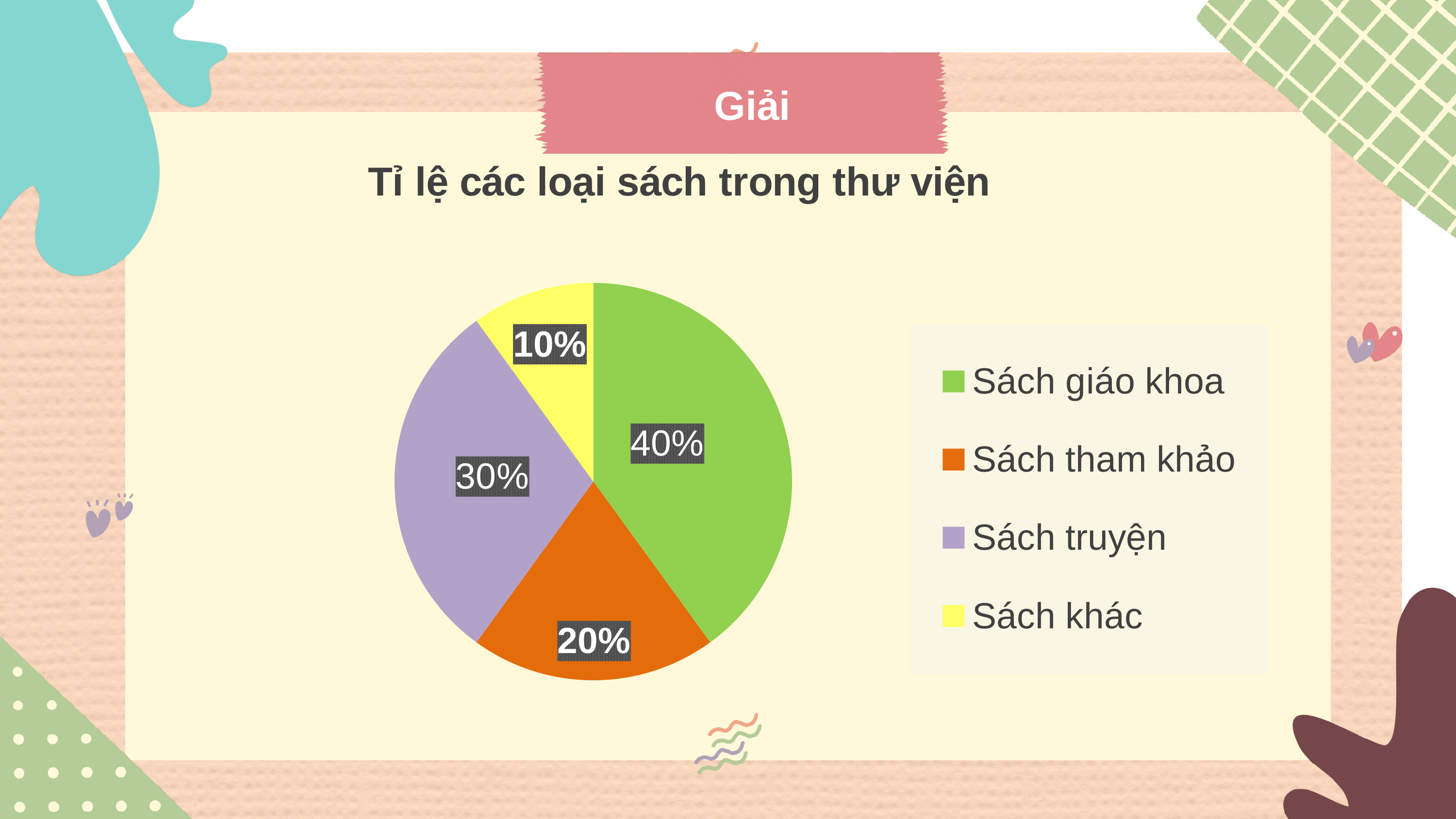
What colour is the slice for Sách truyện? Purple What percentage of the pie chart is Sách tham khảo? 20% Which is larger, the share for Sách tham khảo or the share for Sách truyện? Sách truyện What percentage of the pie chart is Sách giáo khoa? 40% Which category has the largest share of the pie chart? Sách giáo khoa What percentage of the pie chart is Sách truyện? 30% What percentage of the pie chart is Sách khác? 10% Which category has the smallest share of the pie chart? Sách khác What kind of chart is shown on the slide? Pie chart How many categories are shown in the pie chart? 4 What is the difference in percentage points between Sách giáo khoa and Sách truyện? 10% What is the title of the chart? Tỉ lệ các loại sách trong thư viện